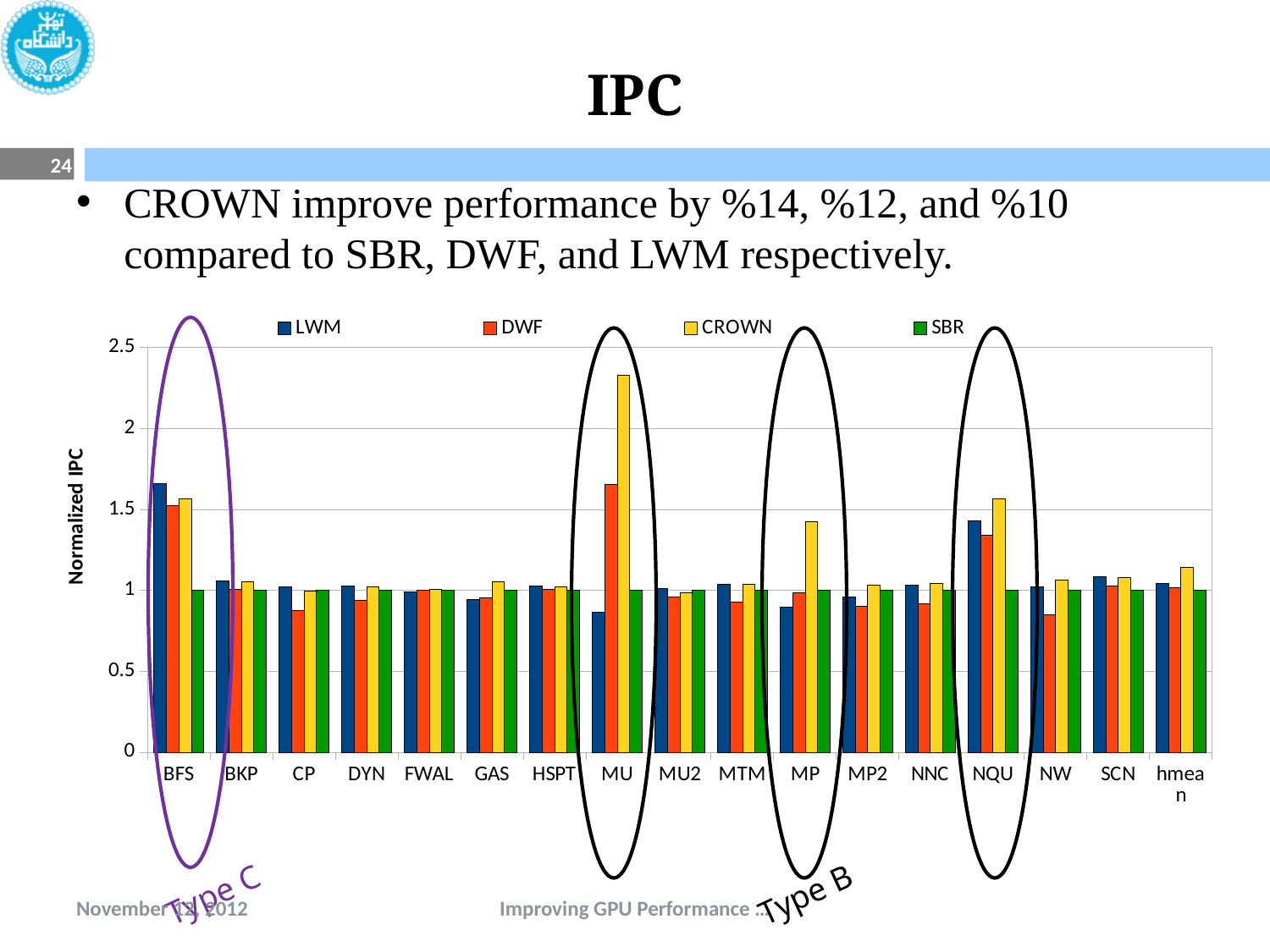
Is the LWM value for BFS greater or less than 1.5? greater Is the CROWN value for MP greater or less than 1.5? less Is the CROWN value for MU greater or less than 2? greater Which series has the highest value for MU? CROWN For which category is the CROWN value highest? MU How many categories are shown along the x axis? 17 How many series does the legend list? 4 What is the label of the y axis? Normalized IPC What kind of chart is shown on the slide? bar chart For NQU, which is larger, the LWM value or the CROWN value? CROWN Which series are listed in the legend? LWM, DWF, CROWN, SBR